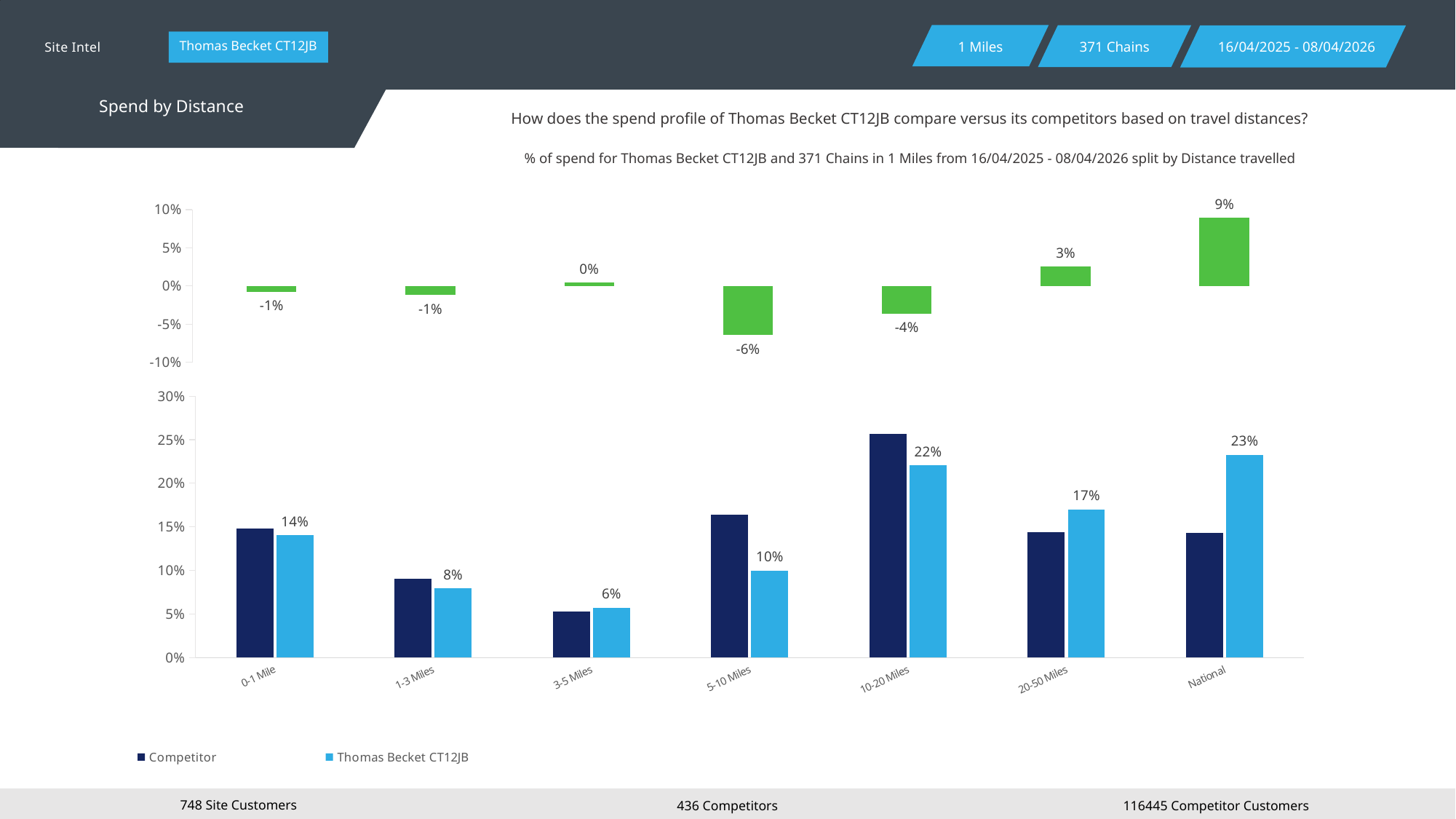
In the bottom chart, for the 5-10 Miles category, which series has the larger value: Competitor or Thomas Becket CT12JB? Competitor How many series does the legend of the bottom chart list? 2 How many distance categories are shown on the x axis of the bottom chart? 7 In the top chart, what is the value for the 5-10 Miles category? -6% In the top chart, which category has the highest value? National In the bottom chart, is the Competitor value for 10-20 Miles greater or less than 25%? greater In the bottom chart, which category has the highest value for Thomas Becket CT12JB? National In the bottom chart, what is the value for Thomas Becket CT12JB in the National category? 23% In the bottom chart, which category has the lowest value for Thomas Becket CT12JB? 3-5 Miles What kind of chart is the bottom chart? bar chart In the bottom chart, what is the difference between the Thomas Becket CT12JB values for 10-20 Miles and 5-10 Miles? 12% In the bottom chart, what is the value for Thomas Becket CT12JB in the 10-20 Miles category? 22%